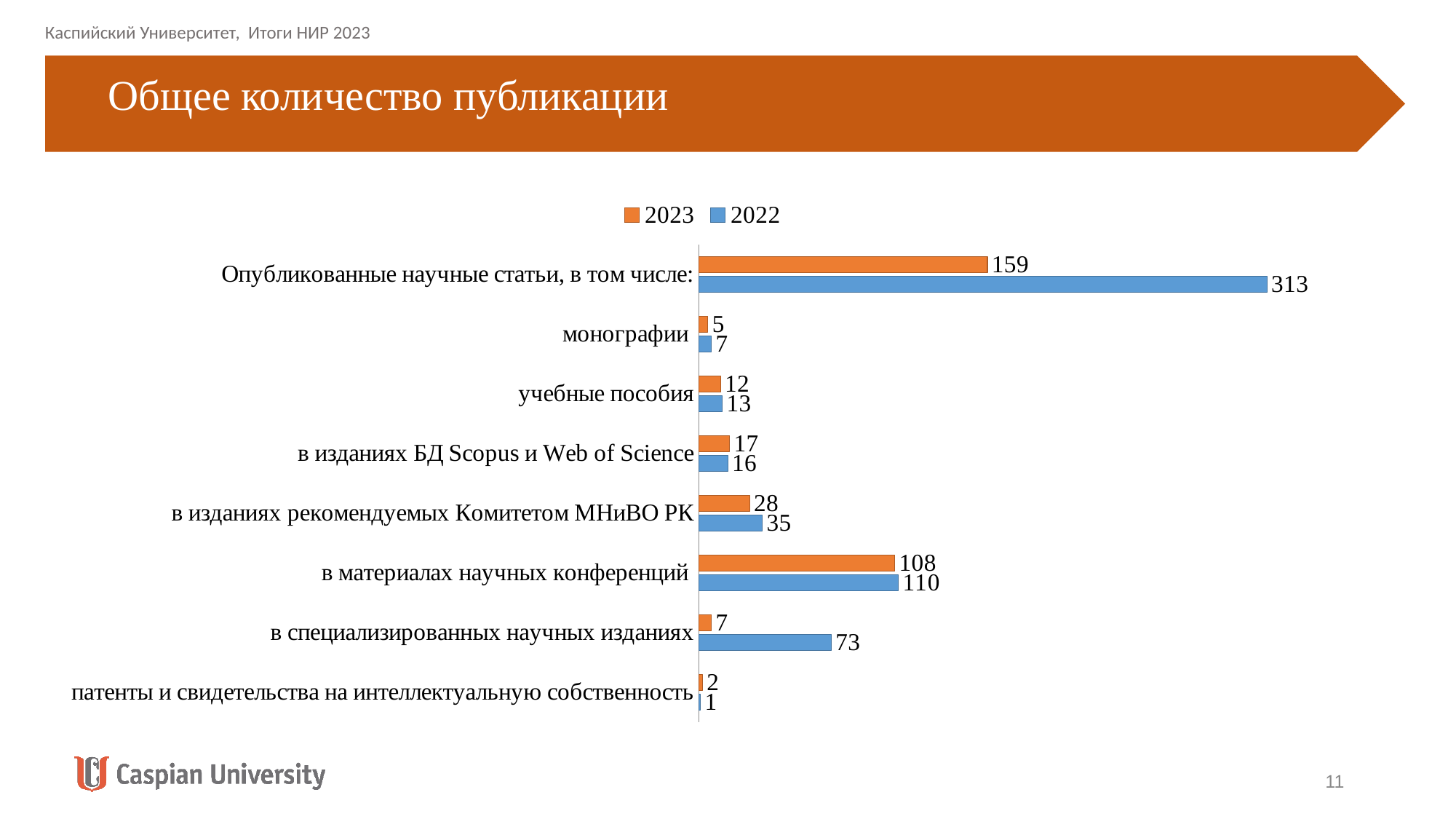
Which category has the highest 2022 value? Опубликованные научные статьи, в том числе: Which category has the lowest 2023 value? патенты и свидетельства на интеллектуальную собственность How many series does the legend list? 2 What is the 2023 value for 'Опубликованные научные статьи, в том числе:'? 159 For 'монографии', which year has the larger value, 2023 or 2022? 2022 For 'в изданиях БД Scopus и Web of Science', which year has the larger value, 2023 or 2022? 2023 What is the difference between the 2022 and 2023 values for 'в специализированных научных изданиях'? 66 What is the 2022 value for 'в специализированных научных изданиях'? 73 What is the 2023 value for 'в изданиях рекомендуемых Комитетом МНиВО РК'? 28 How many categories are shown on the chart? 8 What is the difference between the 2022 and 2023 values for 'Опубликованные научные статьи, в том числе:'? 154 What kind of chart is shown on the slide? Bar chart